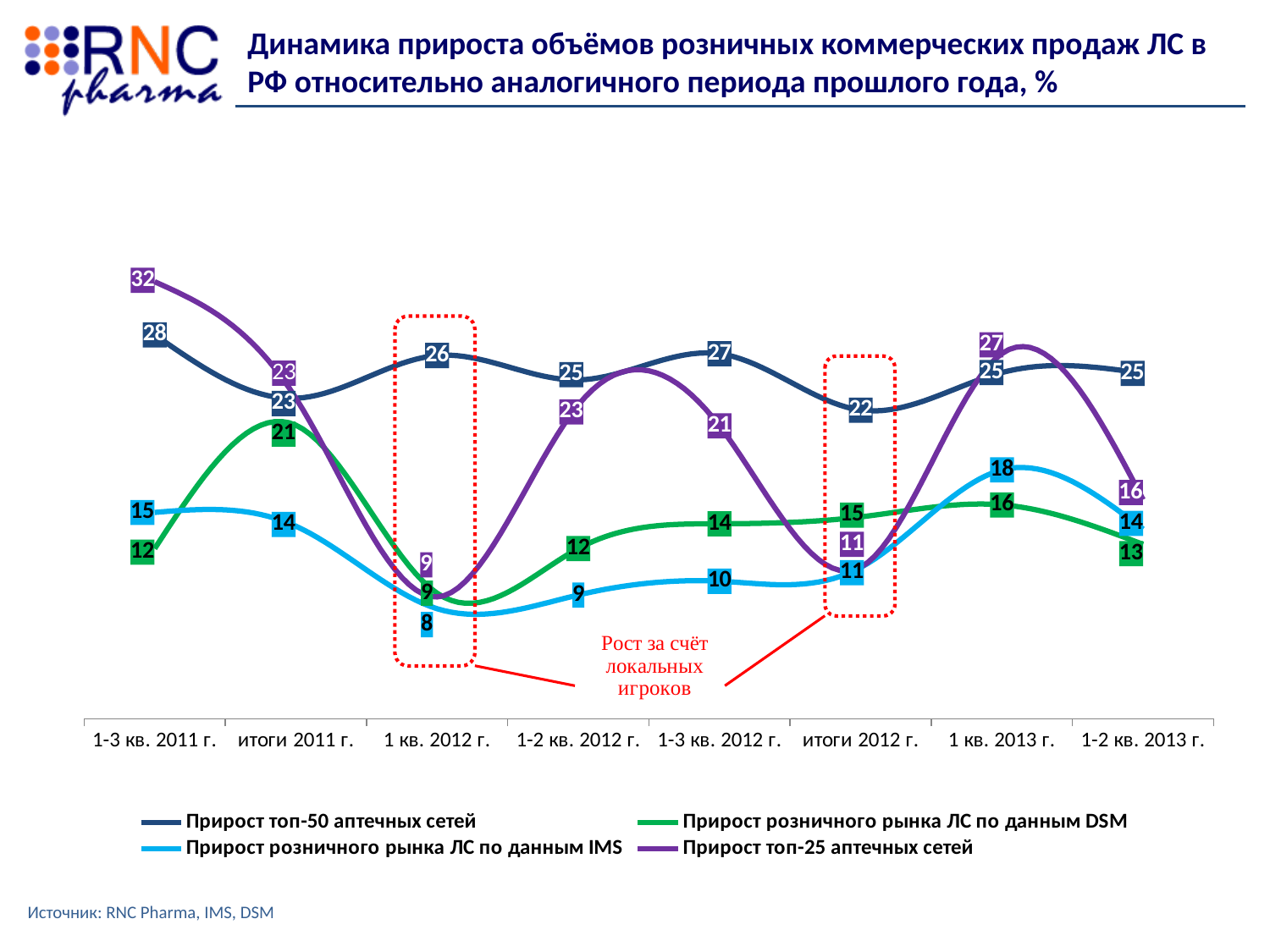
In which period does 'Прирост топ-50 аптечных сетей' have its lowest value? итоги 2012 г. At '1 кв. 2013 г.', what is the difference between 'Прирост топ-50 аптечных сетей' and 'Прирост розничного рынка ЛС по данным IMS'? 7 What is the value for 'Прирост топ-50 аптечных сетей' at '1-3 кв. 2012 г.'? 27 What kind of chart is shown on the slide? Line chart At '1 кв. 2013 г.', which is larger: the DSM series or the IMS series? Прирост розничного рынка ЛС по данным IMS What is the value for 'Прирост топ-25 аптечных сетей' at '1-3 кв. 2011 г.'? 32 What is the value for 'Прирост розничного рынка ЛС по данным DSM' at 'итоги 2011 г.'? 21 What is the value for 'Прирост розничного рынка ЛС по данным IMS' at '1 кв. 2012 г.'? 8 Does 'Прирост топ-25 аптечных сетей' rise or fall from '1 кв. 2013 г.' to '1-2 кв. 2013 г.'? Fall How many periods are shown on the x axis? 8 In which period does 'Прирост топ-25 аптечных сетей' reach its highest value? 1-3 кв. 2011 г. How many series does the legend list? 4